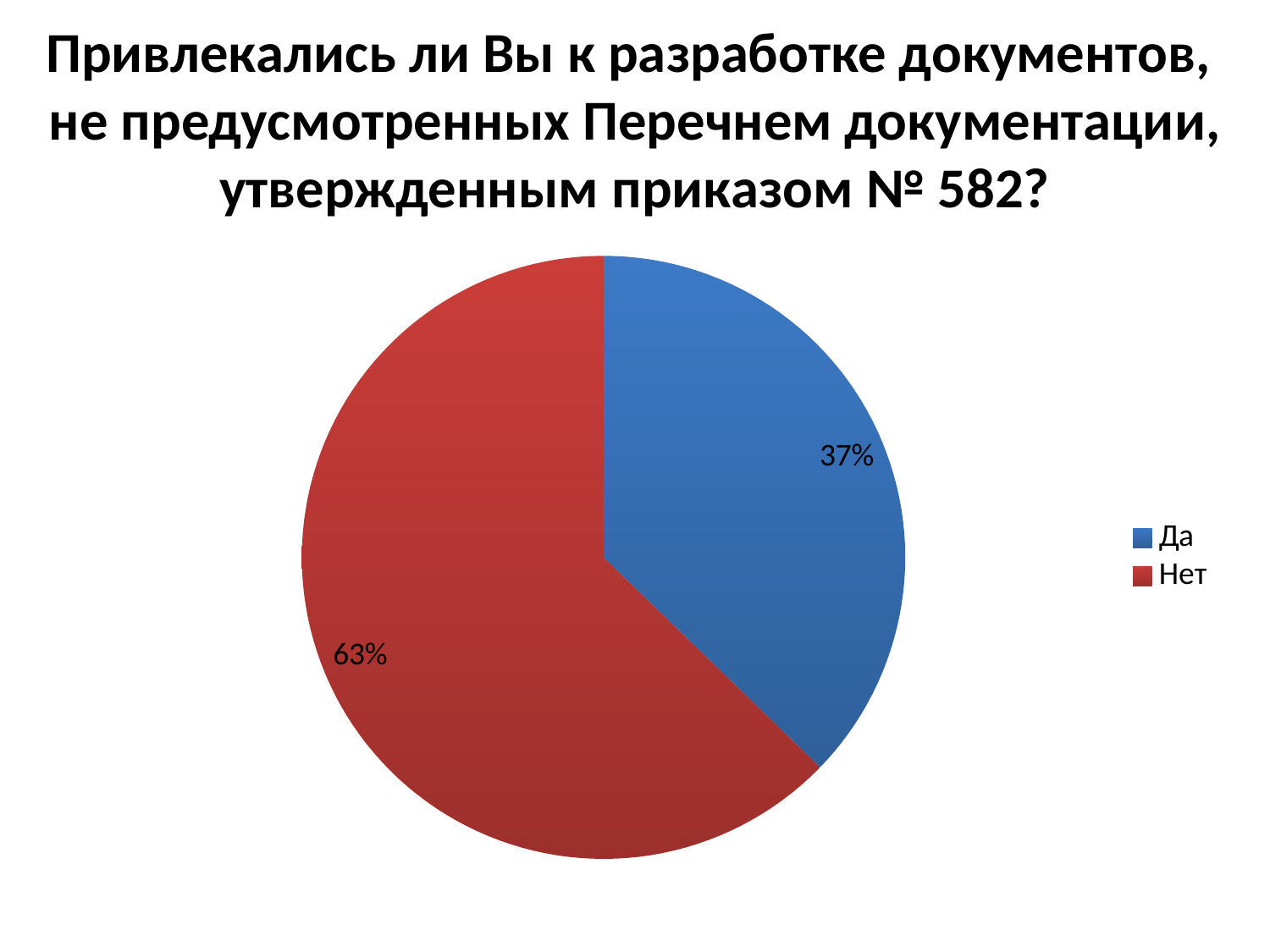
What colour is the "Да" slice? Blue Which answer has the smallest share of the pie? Да Which answer has the largest share of the pie? Нет What kind of chart is shown on the slide? Pie chart How many slices does the pie chart have? 2 How many entries does the legend list? 2 What colour is the "Нет" slice? Red What percentage of respondents answered "Нет"? 63% What share of the pie does the "Да" slice represent? 37% What is the difference in percentage points between the "Нет" and "Да" slices? 26 What percentage of respondents answered "Да"? 37% Which is larger, the share for "Да" or the share for "Нет"? Нет